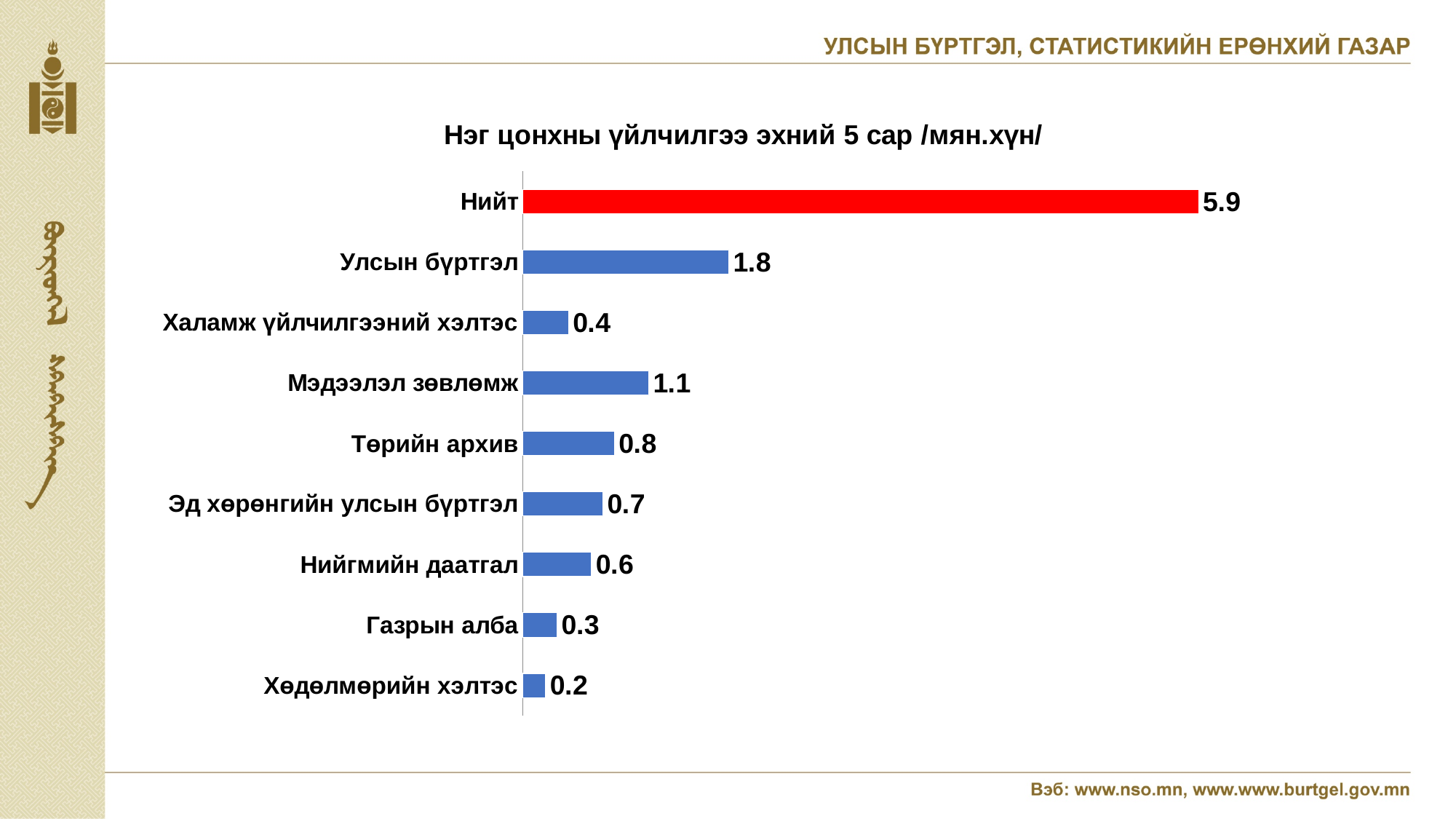
Which category has the lowest value? Хөдөлмөрийн хэлтэс What is the value for Мэдээлэл зөвлөмж? 1.1 What kind of chart is shown on the slide? Bar chart What is the title of the chart? Нэг цонхны үйлчилгээ эхний 5 сар /мян.хүн/ What is the value for Нийт? 5.9 Which is larger, the value for Төрийн архив or the value for Нийгмийн даатгал? Төрийн архив How many bars are shown in the chart? 9 What is the difference between the values for Улсын бүртгэл and Мэдээлэл зөвлөмж? 0.7 Excluding the Нийт total bar, which category has the highest value? Улсын бүртгэл Which bar is coloured red? Нийт What is the value for Хөдөлмөрийн хэлтэс? 0.2 What is the value for Улсын бүртгэл? 1.8